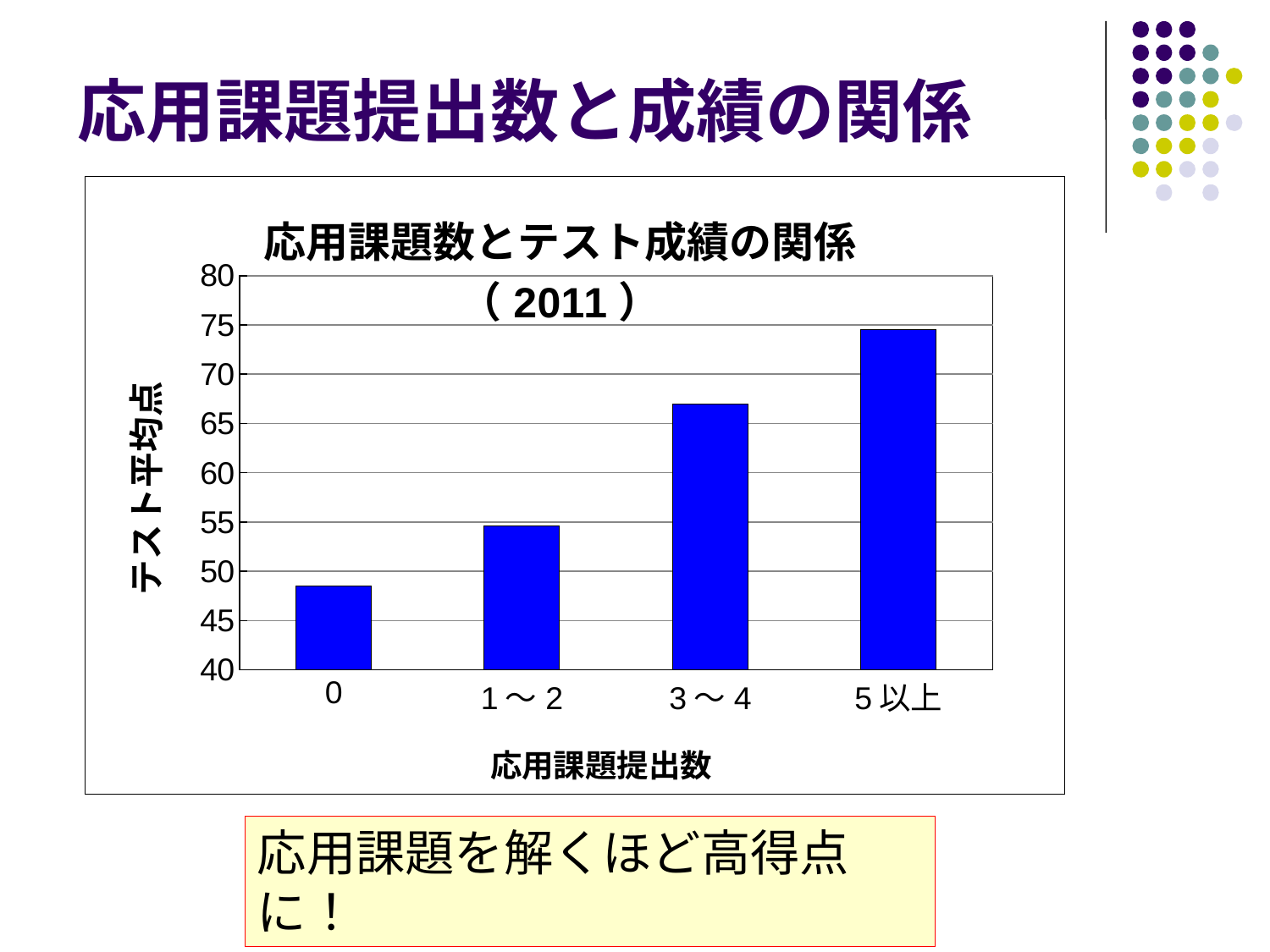
Is the value for 3～4 greater or less than 70? less What kind of chart is shown on the slide? bar chart Is the value for 5以上 greater or less than 70? greater Which category has the highest テスト平均点? 5以上 Which has a higher テスト平均点, 0 or 5以上? 5以上 Which has a higher テスト平均点, 1～2 or 3～4? 3～4 How many categories are shown on the x axis of the chart? 4 Which category has the lowest テスト平均点? 0 Is the value for 1～2 greater or less than 50? greater What is the label of the y axis of the chart? テスト平均点 Do the values rise or fall as 応用課題提出数 increases along the x axis? rise